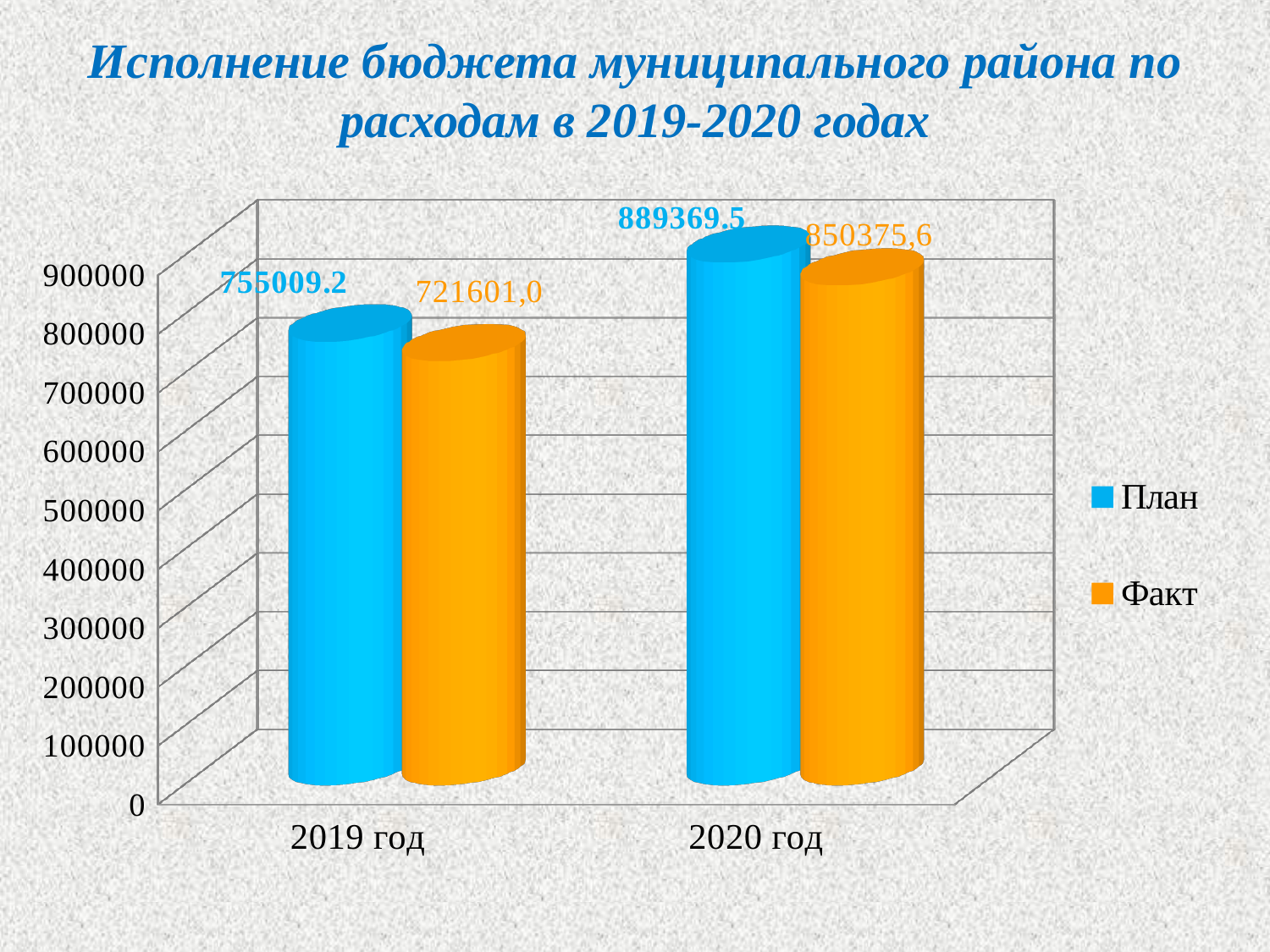
What is the Факт value for 2020 год? 850375,6 What is the План value for 2019 год? 755009.2 Which year has the lowest Факт value? 2019 год How many series does the legend list? 2 What kind of chart is shown on the slide? Bar chart Which is larger for 2019 год, План or Факт? План Which year has the highest План value? 2020 год Do the Факт values rise or fall from 2019 год to 2020 год? Rise What is the difference between the План and Факт values for 2020 год? 38993.9 What is the План value for 2020 год? 889369.5 What is the difference between the План values for 2020 год and 2019 год? 134360.3 What is the Факт value for 2019 год? 721601,0